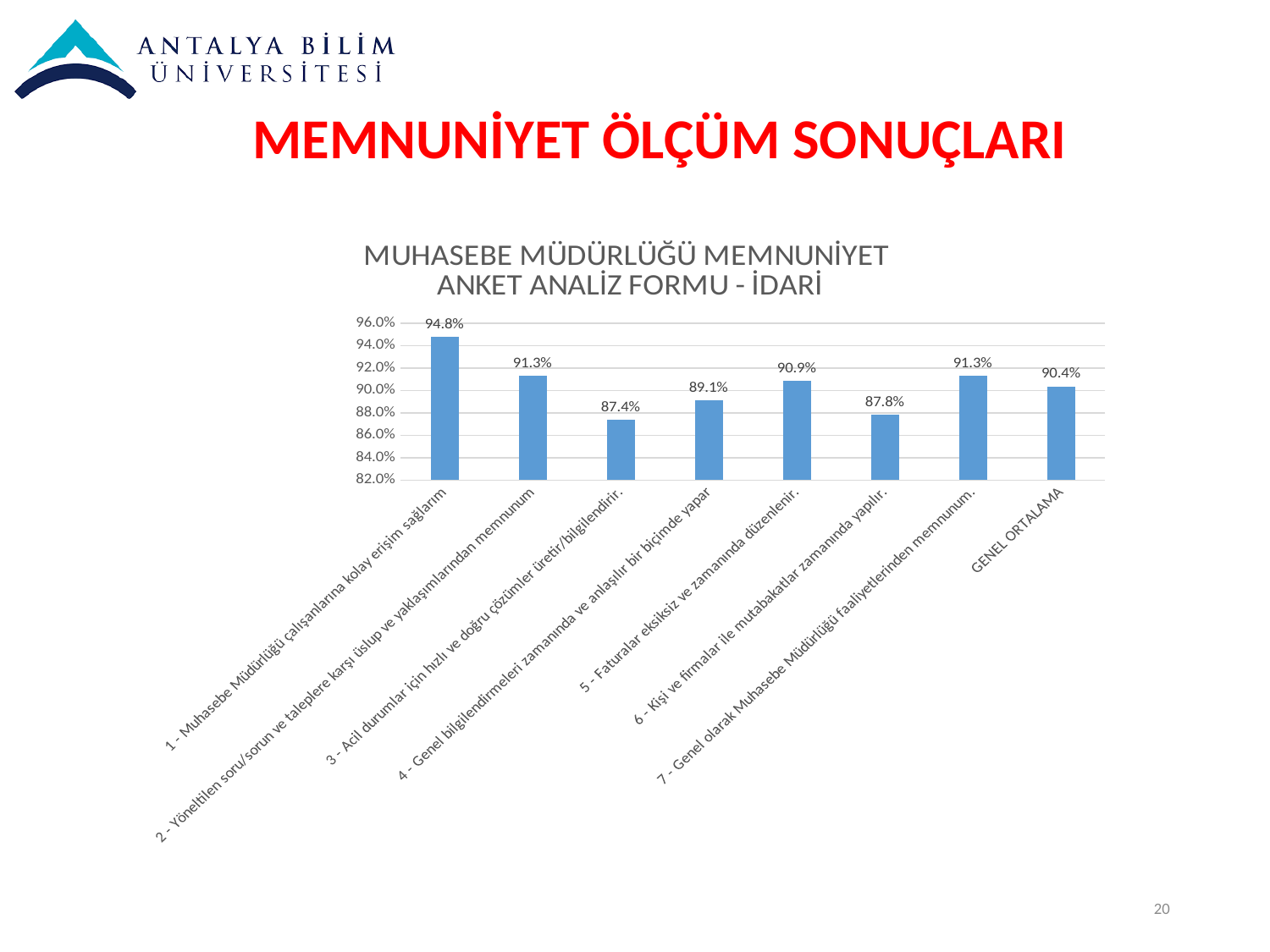
Which category has the lowest value? 3 - Acil durumlar için hızlı ve doğru çözümler üretir/bilgilendirir. What is the value for category 5 (Faturalar eksiksiz ve zamanında düzenlenir)? 90.9% Is the value for category 7 (Genel olarak Muhasebe Müdürlüğü faaliyetlerinden memnunum) greater or less than 90.0%? greater What type of chart is shown on the slide? bar chart What is the title of the chart? MUHASEBE MÜDÜRLÜĞÜ MEMNUNİYET ANKET ANALİZ FORMU - İDARİ What is the value for category 1 (Muhasebe Müdürlüğü çalışanlarına kolay erişim sağlarım)? 94.8% Which is larger, the value for category 4 or the value for category 6? category 4 (89.1%) What is the difference between the value for category 1 and the value for category 3? 7.4% How many bars are plotted in the chart? 8 What is the value for category 3 (Acil durumlar için hızlı ve doğru çözümler üretir/bilgilendirir)? 87.4% Which category has the highest value? 1 - Muhasebe Müdürlüğü çalışanlarına kolay erişim sağlarım What is the value for GENEL ORTALAMA? 90.4%